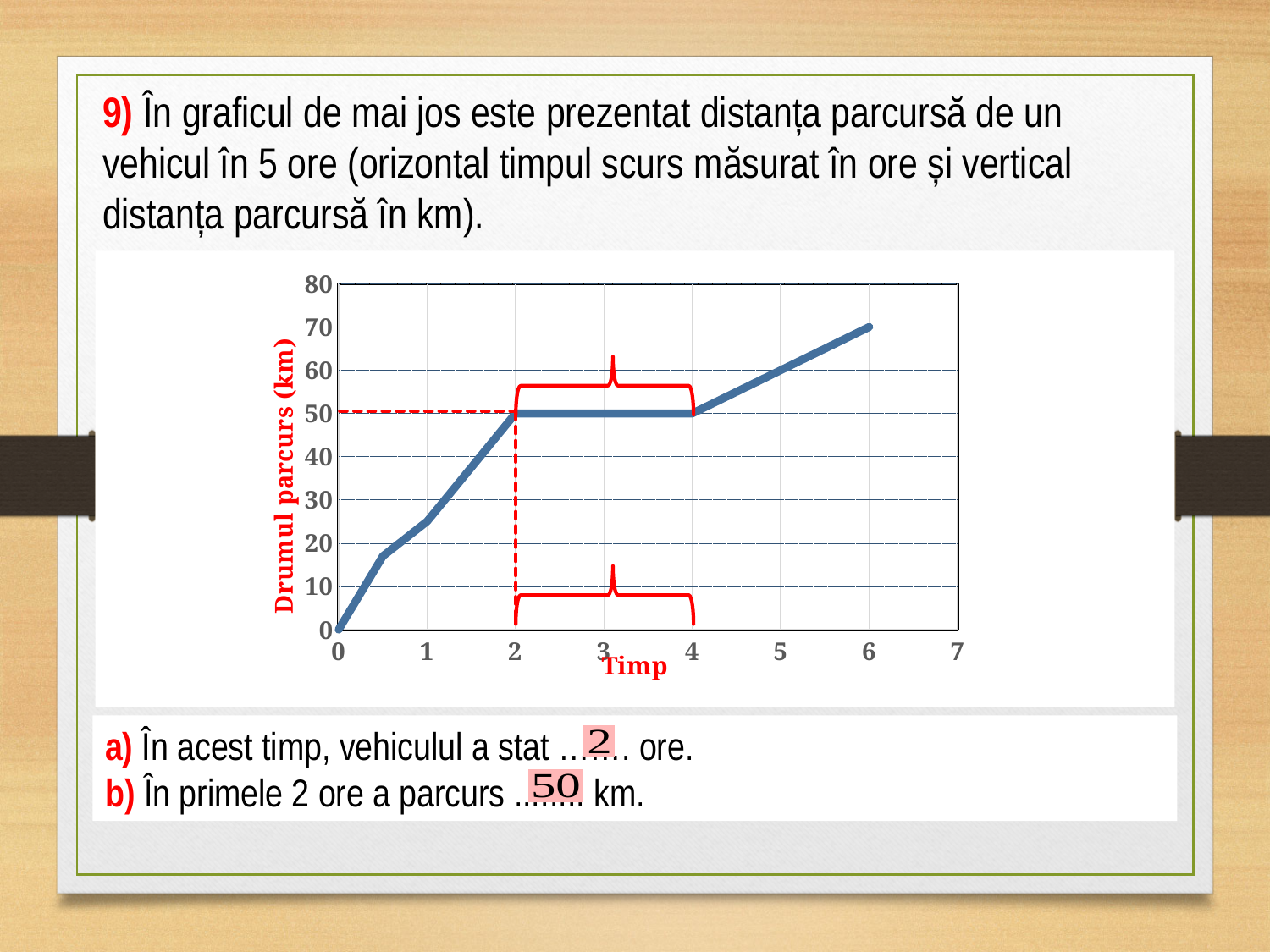
At which time (hours) is the distance covered the highest? 6 What is the title of the horizontal axis? Timp Does the distance rise or fall overall as time increases from 0 to 6 hours? rise By how many km does the distance increase between hour 4 and hour 6? 20 What distance (km) has the vehicle covered after 6 hours? 70 Is the distance covered after 5 hours greater or less than 50 km? greater Between which two hours does the distance stay constant? between 2 and 4 What distance (km) has the vehicle covered after 4 hours? 50 Is the distance covered after 1 hour greater or less than 30 km? less What kind of chart is shown on the slide? line chart What distance (km) has the vehicle covered after 2 hours? 50 What is the title of the vertical axis? Drumul parcurs (km)